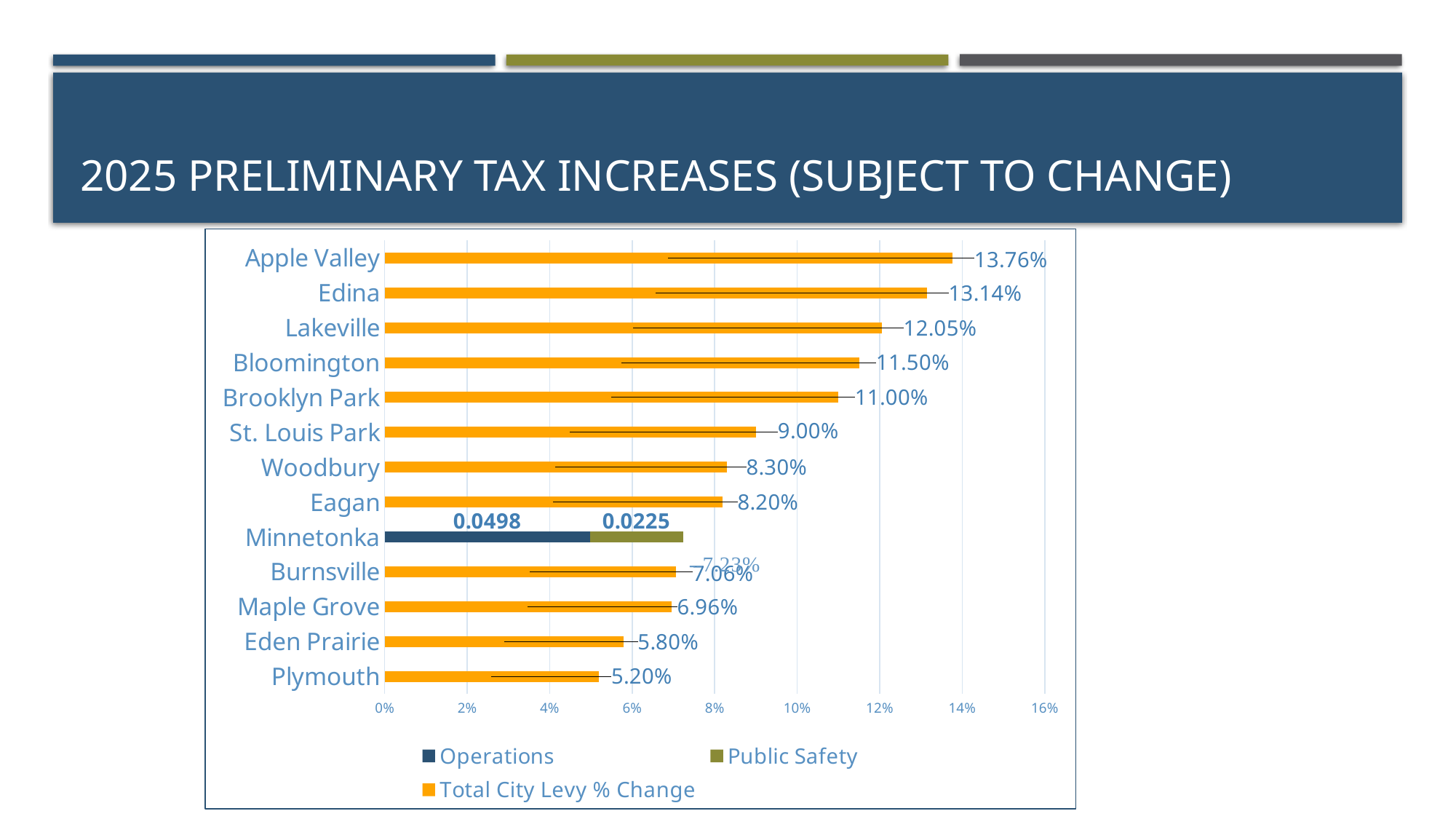
How many series does the legend list? 3 Which city has the lowest Total City Levy % Change? Plymouth What is the Public Safety value shown for Minnetonka? 0.0225 What is the Operations value shown for Minnetonka? 0.0498 How many cities are listed on the chart? 13 What is the total of the stacked bar for Minnetonka (Operations plus Public Safety)? 0.0723 What kind of chart is shown on the slide? Bar chart What is the difference between the Total City Levy % Change for Apple Valley and Edina? 0.62% Which has a larger Total City Levy % Change, Woodbury or Eden Prairie? Woodbury Which city has the highest Total City Levy % Change? Apple Valley What is the Total City Levy % Change for Brooklyn Park? 11.00% What is the Total City Levy % Change for Apple Valley? 13.76%